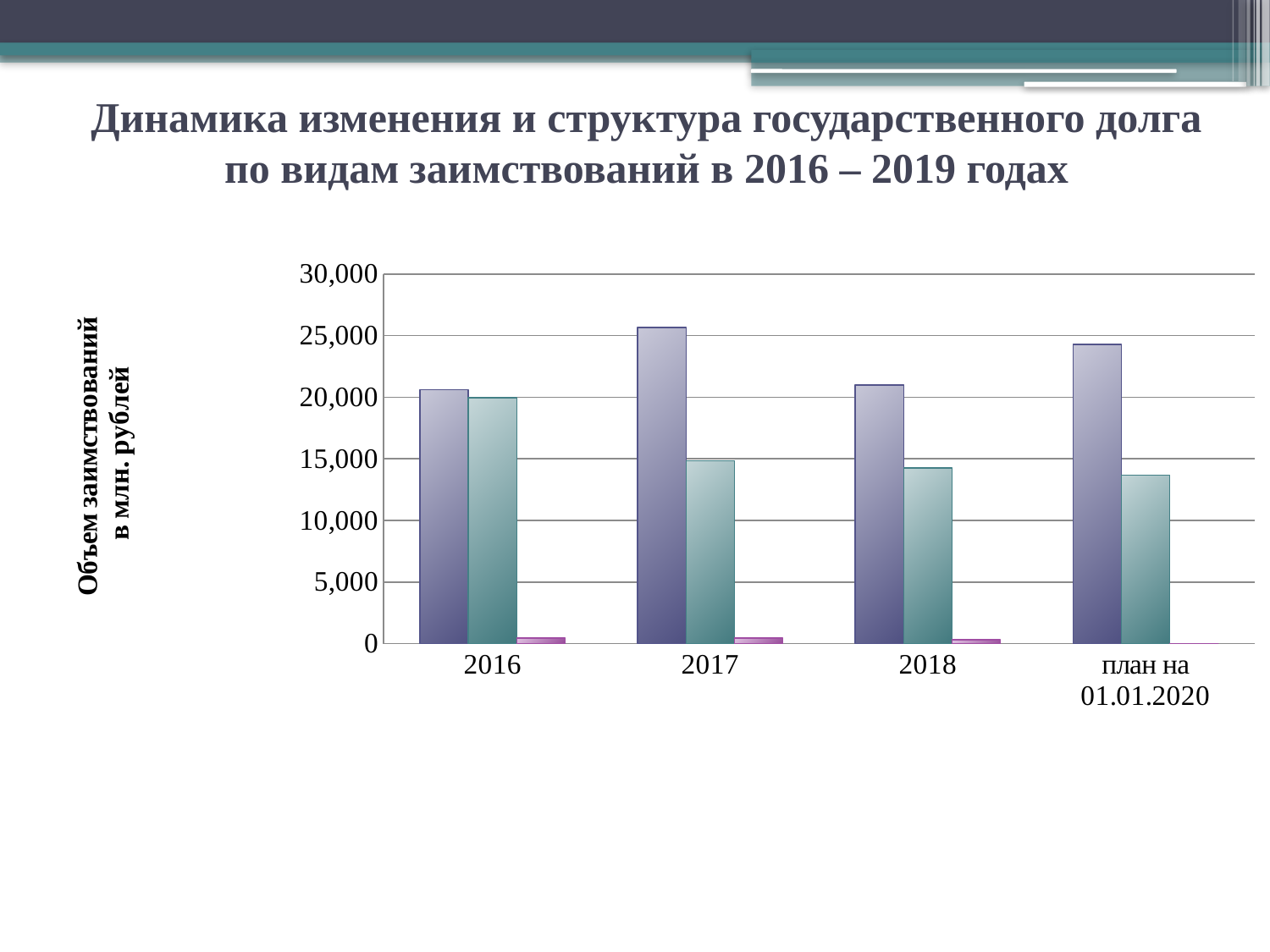
In which category is the teal (second) bar the tallest? 2016 How many categories are shown along the x axis of the chart? 4 How many bars are plotted for each category on the chart? 3 Does the teal (second) bar rise or fall from 2016 to план на 01.01.2020? fall What kind of chart is shown on the slide? bar chart Is the value of the purple bar for план на 01.01.2020 greater or less than 25,000? less What is the label on the vertical axis of the chart? Объем заимствований в млн. рублей For 2017, which bar is taller: the purple bar or the teal bar? the purple bar Is the value of the purple bar for 2017 greater or less than 25,000? greater In which category is the purple (first) bar the tallest? 2017 In which category is the teal (second) bar the shortest? план на 01.01.2020